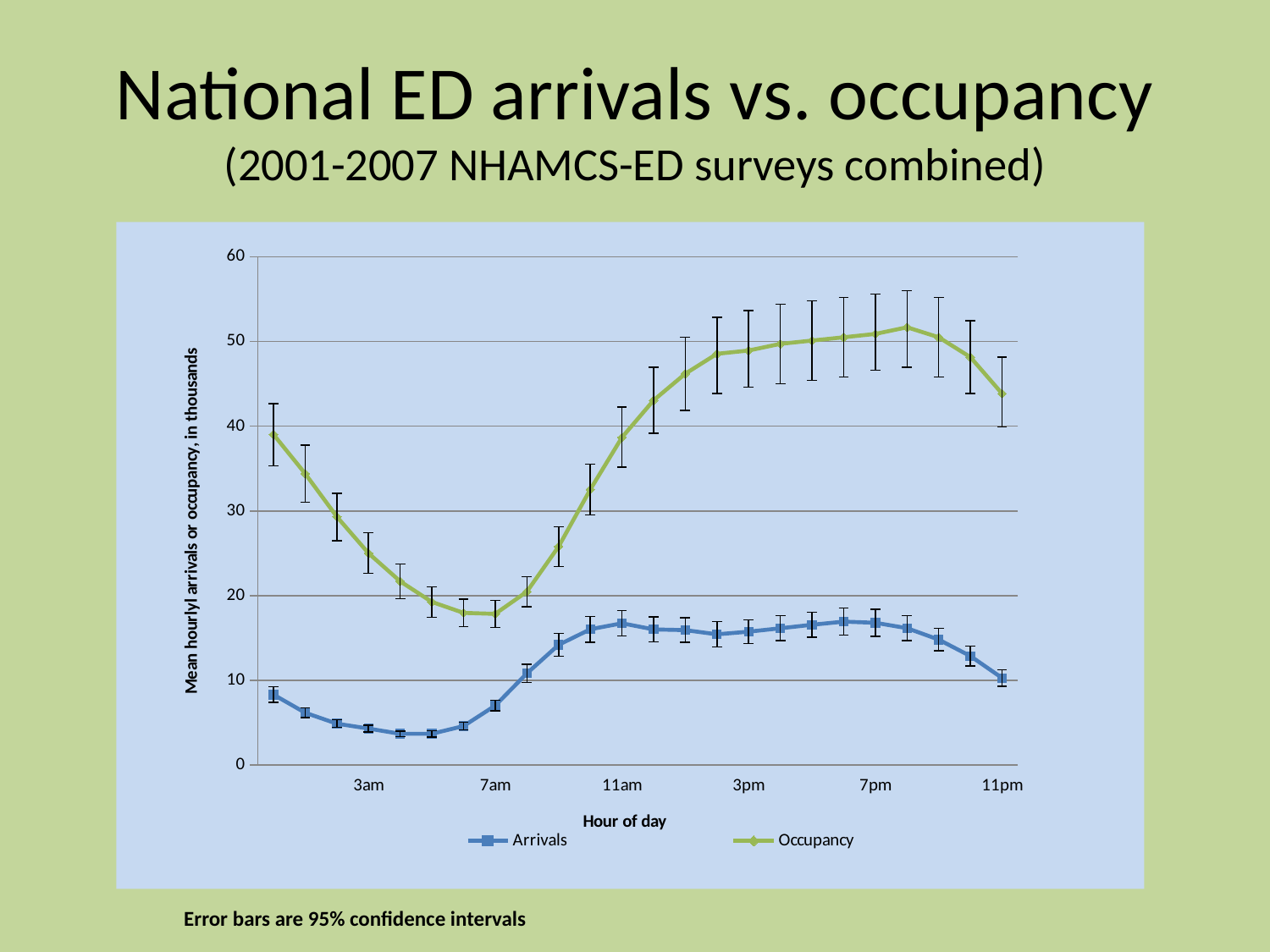
What kind of chart is shown on the slide? line chart Is the Occupancy value at 3am greater or less than 20? greater Is the Arrivals value at 3am greater or less than 10? less Does the Arrivals line rise or fall between 7am and 11am? rise What is the title of the vertical axis? Mean hourlyl arrivals or occupancy, in thousands How many series does the legend list? 2 What are the two series named in the legend? Arrivals and Occupancy Is the Occupancy value at 7am greater or less than 20? less Does the Occupancy line rise or fall between 3am and 7am? fall At 3pm, which series has the larger value, Arrivals or Occupancy? Occupancy